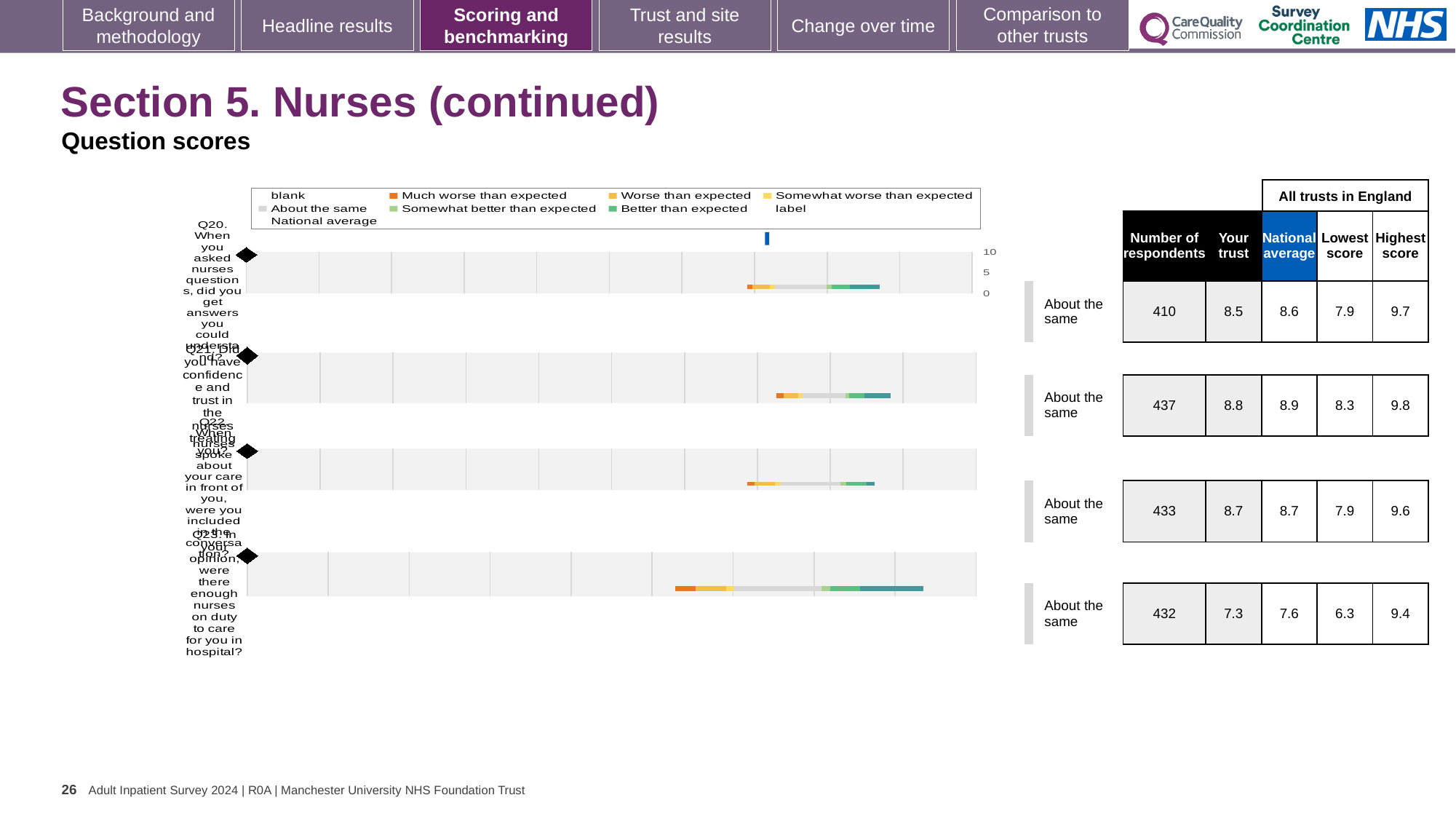
Is the 'Your trust' score larger for Q21 or for Q23 in the table beside the chart? Q21 In the table beside the chart, what is the national average for Q23? 7.6 Which question has the lowest 'Your trust' score in the table beside the chart? Q23 In the table beside the chart, how many respondents answered Q21? 437 In the table beside the chart, what is the 'Your trust' score for Q20? 8.5 Which legend entry in the chart is shown in orange? Much worse than expected What is the difference between the highest score and the lowest score for Q22 in the table beside the chart? 1.7 Which question has the highest 'Your trust' score in the table beside the chart? Q21 Which legend entry in the chart is shown in light grey? About the same How many entries does the chart's legend list? 9 How many questions (categories) are plotted in the chart? 4 What kind of chart is shown on the slide? bar chart